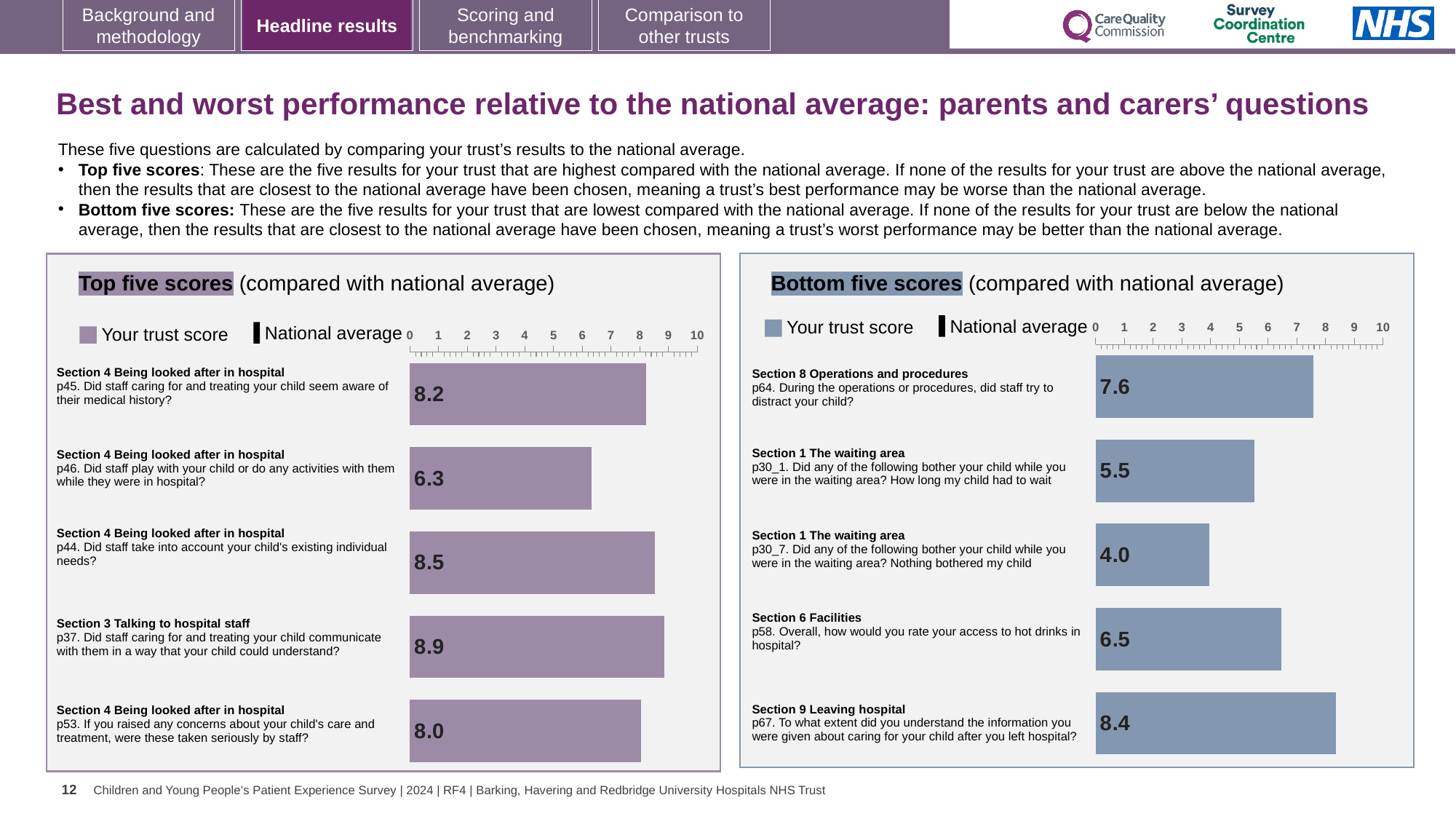
What kind of chart is the Top five scores chart? Bar chart In the Top five scores chart, which has the larger trust score: p45 (aware of their medical history) or p53 (concerns taken seriously by staff)? p45 In the Bottom five scores chart, what is the difference between the trust scores for p67 and p30_7? 4.4 How many series does the legend of the Bottom five scores chart list? 2 In the Bottom five scores chart, which question has the lowest trust score? p30_7. Did any of the following bother your child while you were in the waiting area? Nothing bothered my child In the Bottom five scores chart, which question has the highest trust score? p67. To what extent did you understand the information you were given about caring for your child after you left hospital? In the Top five scores chart, which question has the lowest trust score? p46. Did staff play with your child or do any activities with them while they were in hospital? In the Top five scores chart, what is the trust score for p37 (Did staff caring for and treating your child communicate with them in a way that your child could understand?)? 8.9 In the Top five scores chart, what is the difference between the trust scores for p37 and p46? 2.6 How many questions are plotted in the Bottom five scores chart? 5 In the Bottom five scores chart, what is the trust score for p30_7 (Nothing bothered my child)? 4.0 In the Top five scores chart, which question has the highest trust score? p37. Did staff caring for and treating your child communicate with them in a way that your child could understand?